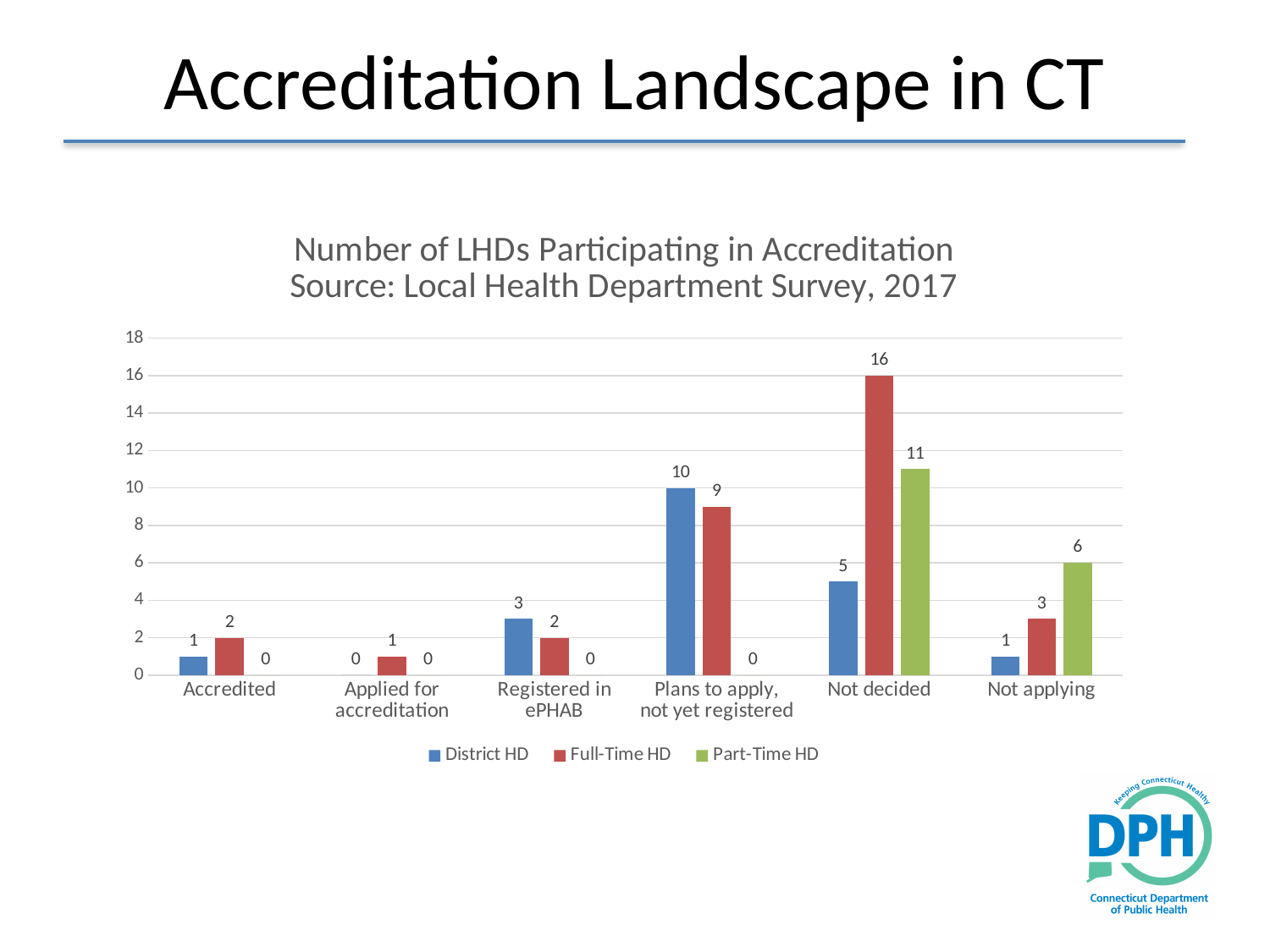
Which category has the highest Full-Time HD value? Not decided How many series does the legend list? 3 What is the total of the three series in the Accredited category? 3 What is the difference between the Full-Time HD and Part-Time HD values in the Not decided category? 5 Which category has the highest District HD value? Plans to apply, not yet registered What is the value for District HD in the Plans to apply, not yet registered category? 10 What is the value for Full-Time HD in the Not decided category? 16 Which is larger in the Not applying category, Full-Time HD or Part-Time HD? Part-Time HD How many categories are shown on the x axis? 6 What is the value for Part-Time HD in the Not applying category? 6 What is the title of the chart? Number of LHDs Participating in Accreditation Source: Local Health Department Survey, 2017 What kind of chart is shown on the slide? Bar chart